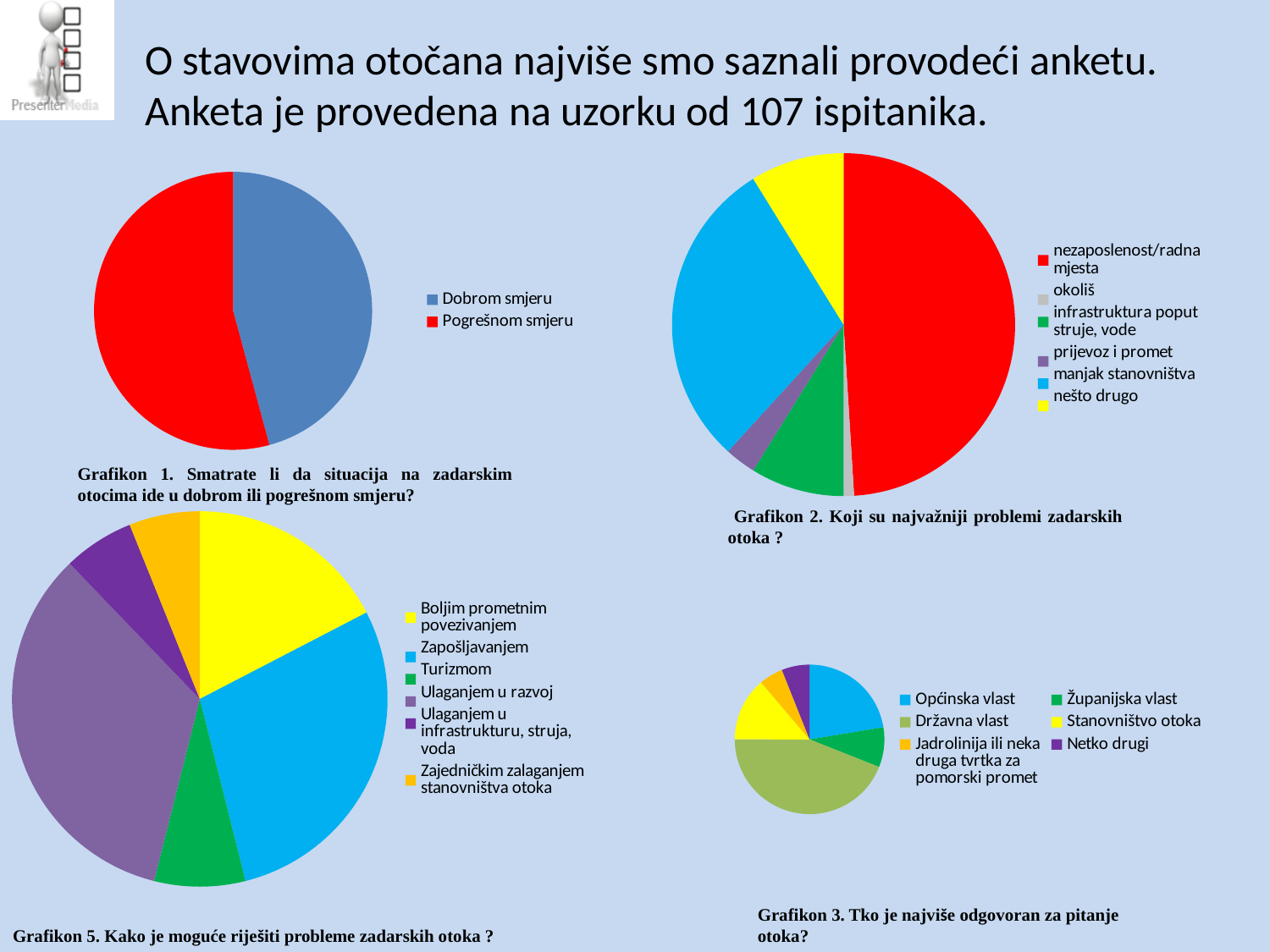
In Grafikon 5, which slice is larger: Zapošljavanjem or Turizmom? Zapošljavanjem What kind of chart is Grafikon 1 (Smatrate li da situacija na zadarskim otocima ide u dobrom ili pogrešnom smjeru?)? Pie chart How many categories does the legend of Grafikon 2 list? 6 How many categories does the legend of Grafikon 5 list? 6 In Grafikon 2, which slice is larger: manjak stanovništva or prijevoz i promet? manjak stanovništva How many categories does the legend of Grafikon 1 list? 2 In Grafikon 3 (Tko je najviše odgovoran za pitanje otoka?), which category has the largest slice? Državna vlast In Grafikon 2 (Koji su najvažniji problemi zadarskih otoka?), which category has the largest slice? nezaposlenost/radna mjesta In Grafikon 3, which slice is larger: Općinska vlast or Županijska vlast? Općinska vlast In Grafikon 5 (Kako je moguće riješiti probleme zadarskih otoka?), which category has the largest slice? Ulaganjem u razvoj How many pie charts are shown on the slide? 4 In Grafikon 2, which category has the smallest slice? okoliš